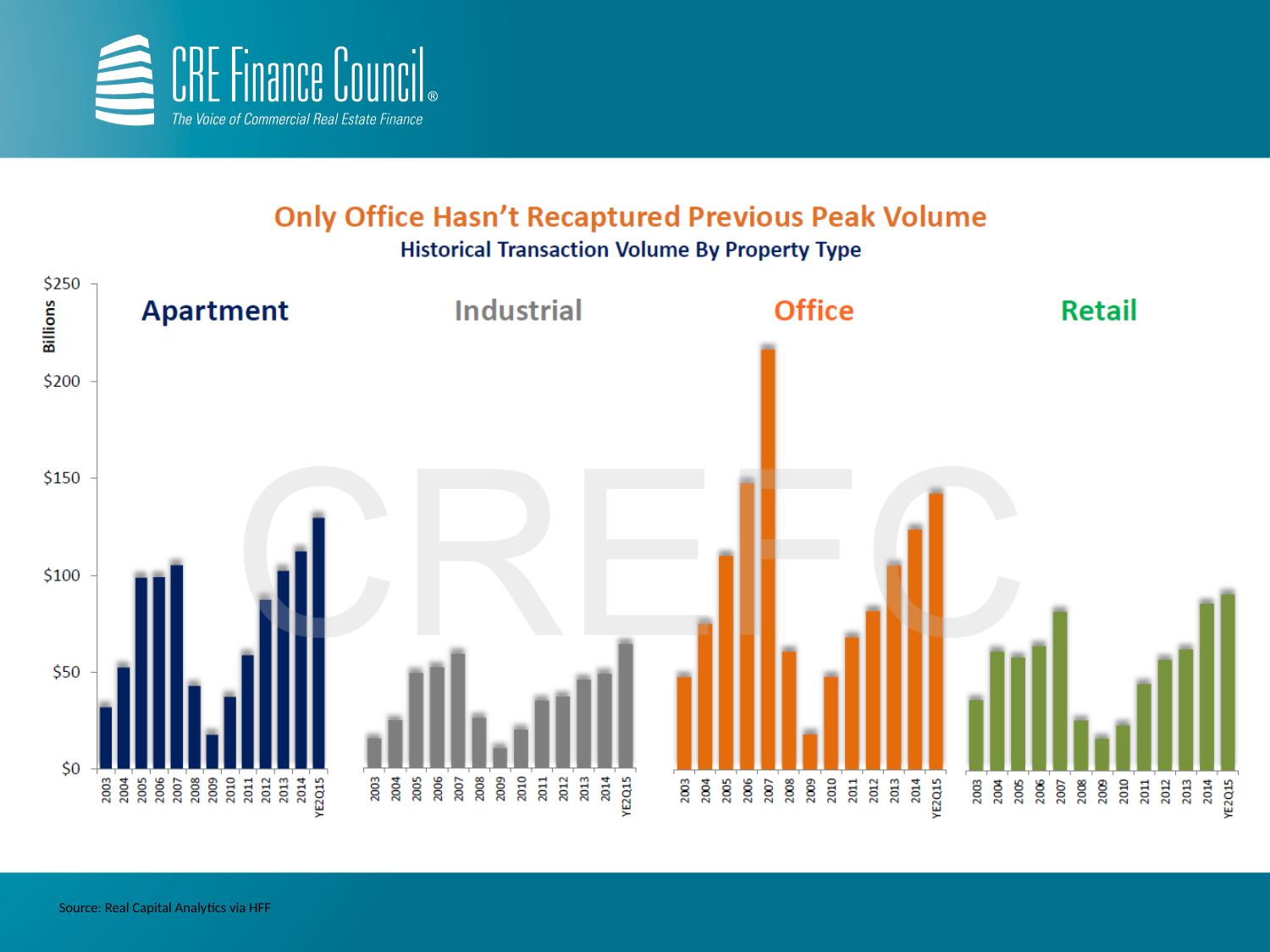
Which is larger, the Apartment volume for YE2Q15 or the Industrial volume for YE2Q15? Apartment YE2Q15 Is the Office transaction volume for 2007 greater or less than $200 billion? greater Is the Retail transaction volume for YE2Q15 greater or less than $100 billion? less What kind of chart is shown on the slide? bar chart Is the Apartment transaction volume for YE2Q15 greater or less than $100 billion? greater Which year has the lowest transaction volume for the Industrial property type? 2009 Which year has the lowest transaction volume for the Apartment property type? 2009 What is the title of the chart? Only Office Hasn't Recaptured Previous Peak Volume How many bars (time periods) are plotted for the Apartment property type? 13 Do Apartment transaction volumes rise or fall from 2009 to YE2Q15? rise Which property type and year has the highest transaction volume in the chart? Office, 2007 How many property types are shown in the chart? 4